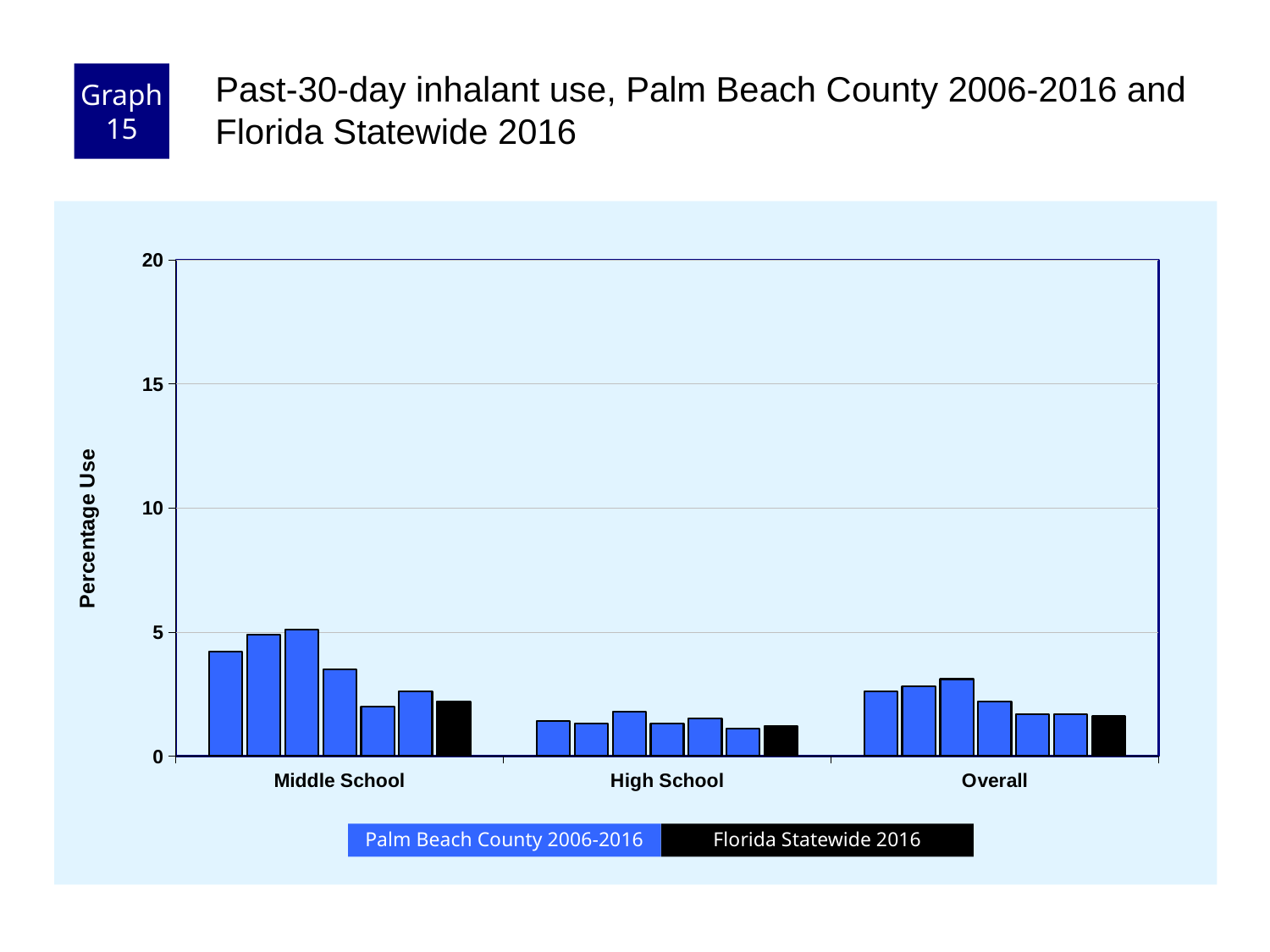
What kind of chart is shown on the slide? bar chart What is the label on the y axis? Percentage Use How many school-level categories are shown on the x axis? 3 Is the Florida Statewide 2016 value for High School greater or less than 5? less Is the first Palm Beach County bar for Middle School greater or less than 5? less Which is larger: the Florida Statewide 2016 bar for Middle School or the Florida Statewide 2016 bar for High School? Middle School Are any bars in the High School group greater than 10? No What colour represents Florida Statewide 2016 in the legend? black Which category group contains the tallest bar? Middle School Which category group has the lowest bars overall? High School How many series does the legend list? 2